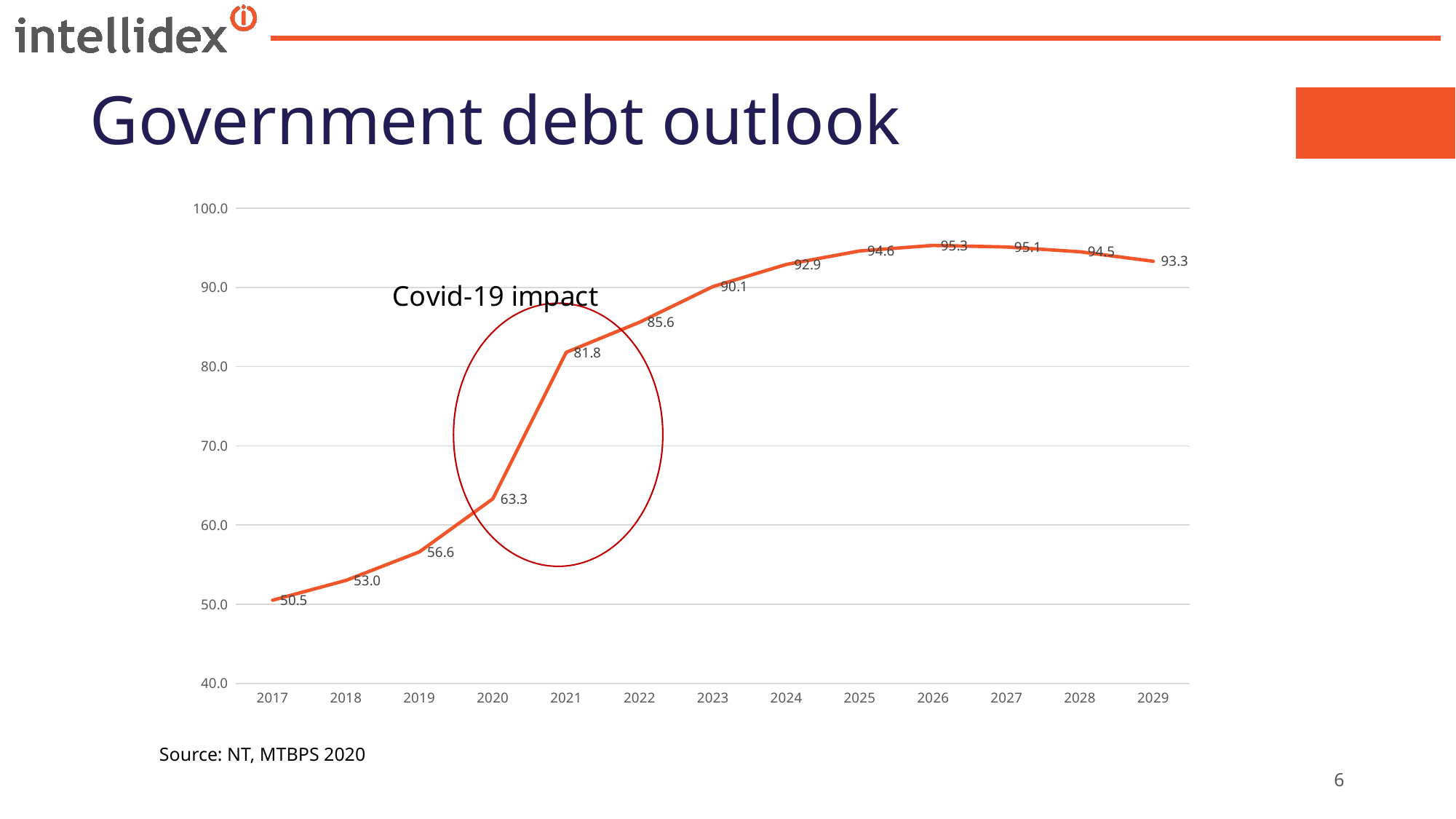
What is the value for 2020? 63.3 Which year has the highest value? 2026 What is the value for 2021? 81.8 What label is written next to the circled part of the line? Covid-19 impact Which is larger, the value for 2024 or the value for 2028? 2028 Is the value for 2022 greater or less than 80.0? greater What is the difference between the values for 2021 and 2020? 18.5 How many years are plotted on the x axis? 13 Do the values rise or fall from 2017 to 2026? rise Which year has the lowest value? 2017 What is the value for 2029? 93.3 What kind of chart is shown? line chart